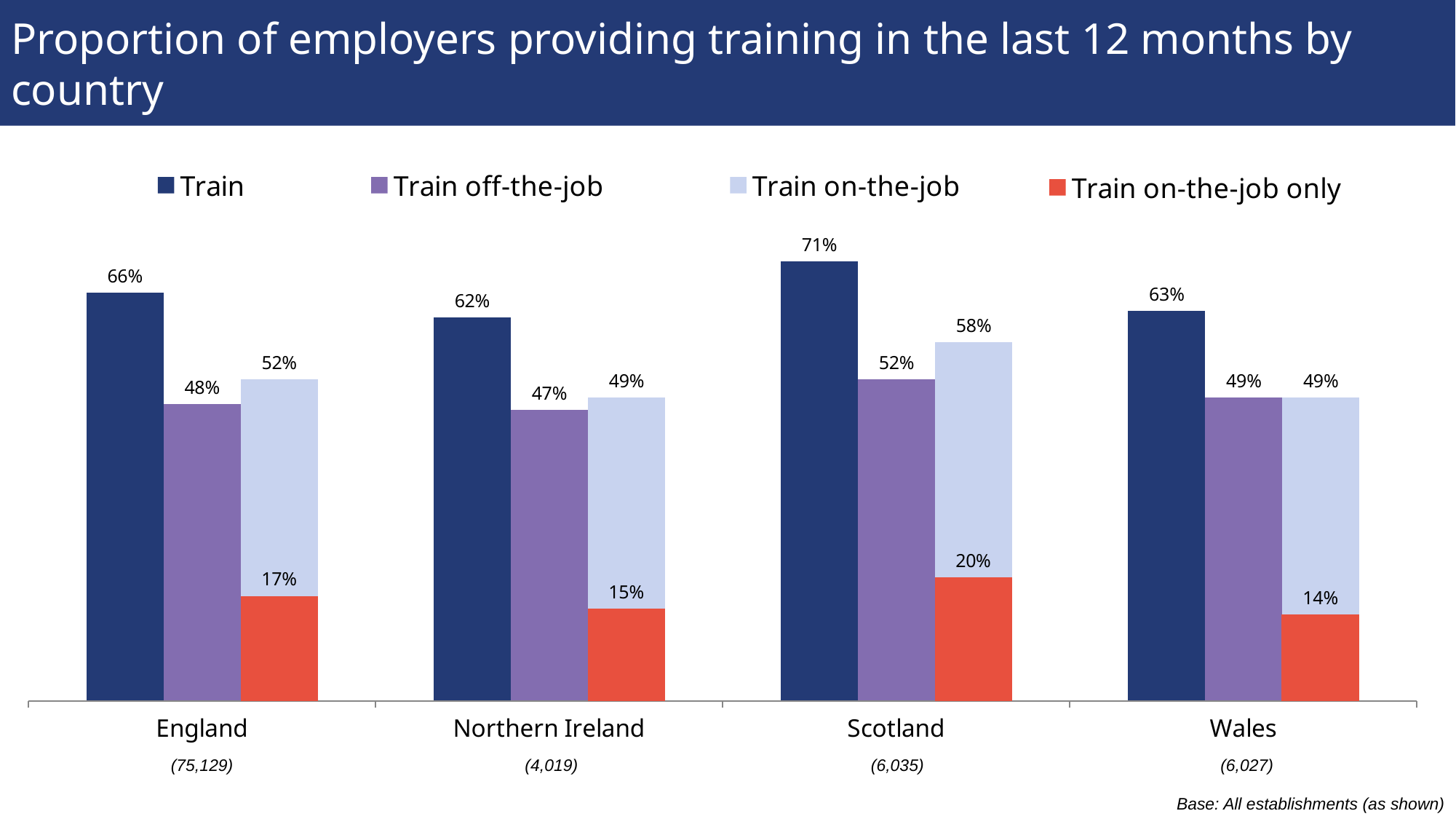
How many series does the legend list? 4 Is the Train on-the-job value higher in Scotland or in England? Scotland What is the value for Train on-the-job only in Wales? 14% What kind of chart is shown on the slide? Bar chart What percentage of employers in Scotland train? 71% Which country has the highest proportion of employers that train? Scotland What is the difference between the Train value for Scotland and the Train value for Northern Ireland? 9 percentage points What is the base size shown for England? 75,129 Which country has the lowest value for Train on-the-job only? Wales Which series is shown in red? Train on-the-job only What is the value for Train off-the-job in Northern Ireland? 47% How many countries are shown on the x axis? 4